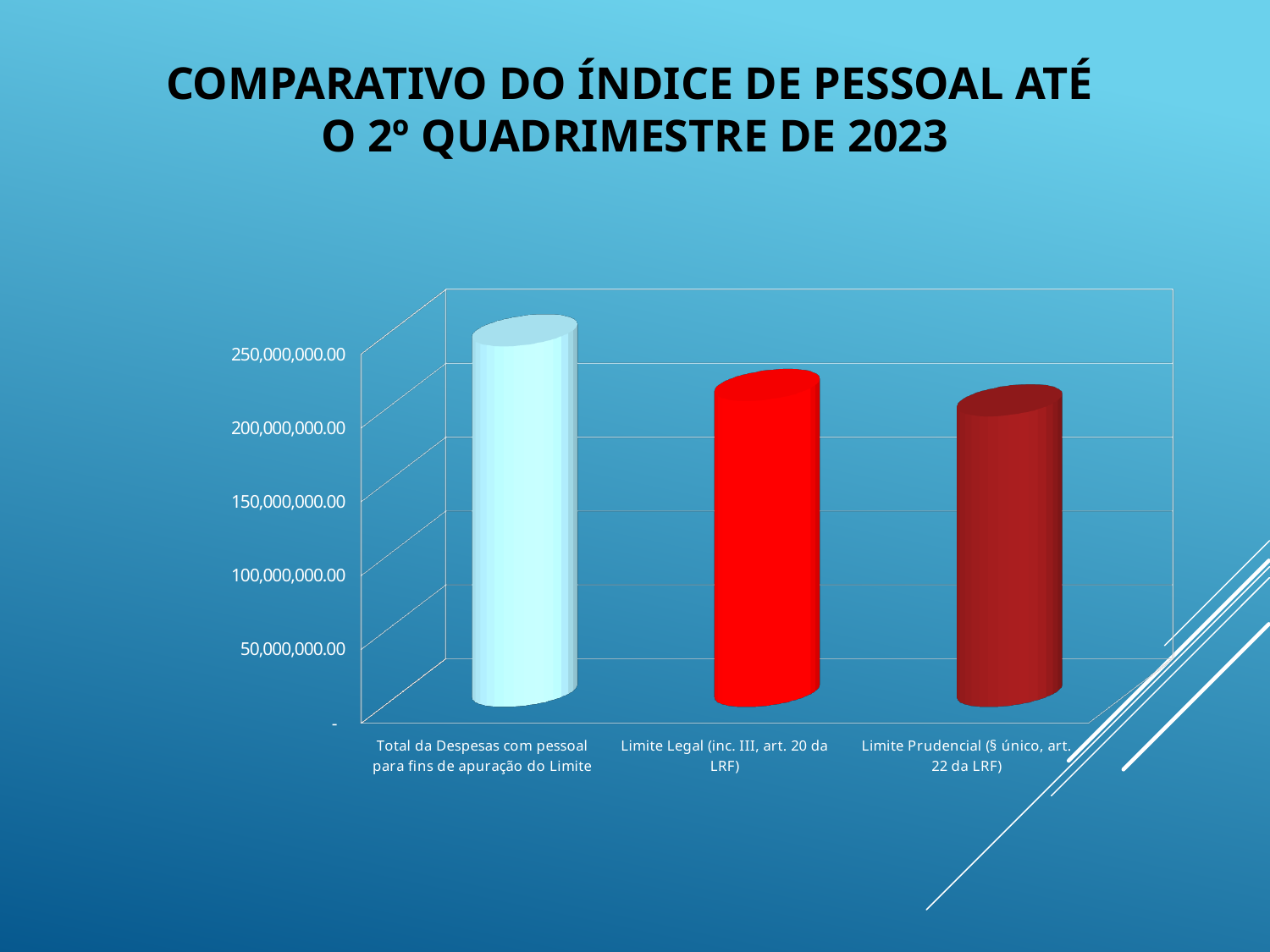
Is the value for Limite Legal (inc. III, art. 20 da LRF) greater or less than 150,000,000.00? greater What kind of chart is shown on the slide? bar chart Which is larger: the value for Total da Despesas com pessoal para fins de apuração do Limite or the value for Limite Prudencial (§ único, art. 22 da LRF)? Total da Despesas com pessoal para fins de apuração do Limite Which category has the lowest value in the chart? Limite Prudencial (§ único, art. 22 da LRF) Is the value for Limite Prudencial (§ único, art. 22 da LRF) greater or less than 100,000,000.00? greater Do the values rise or fall from left to right across the categories? fall Which is larger: the value for Limite Legal (inc. III, art. 20 da LRF) or the value for Limite Prudencial (§ único, art. 22 da LRF)? Limite Legal (inc. III, art. 20 da LRF) Is the value for Total da Despesas com pessoal para fins de apuração do Limite greater or less than 200,000,000.00? greater What colour is the bar for Limite Legal (inc. III, art. 20 da LRF)? red How many categories are plotted in the chart? 3 What is the title of the slide containing the chart? COMPARATIVO DO ÍNDICE DE PESSOAL ATÉ O 2º QUADRIMESTRE DE 2023 Which category has the highest value in the chart? Total da Despesas com pessoal para fins de apuração do Limite